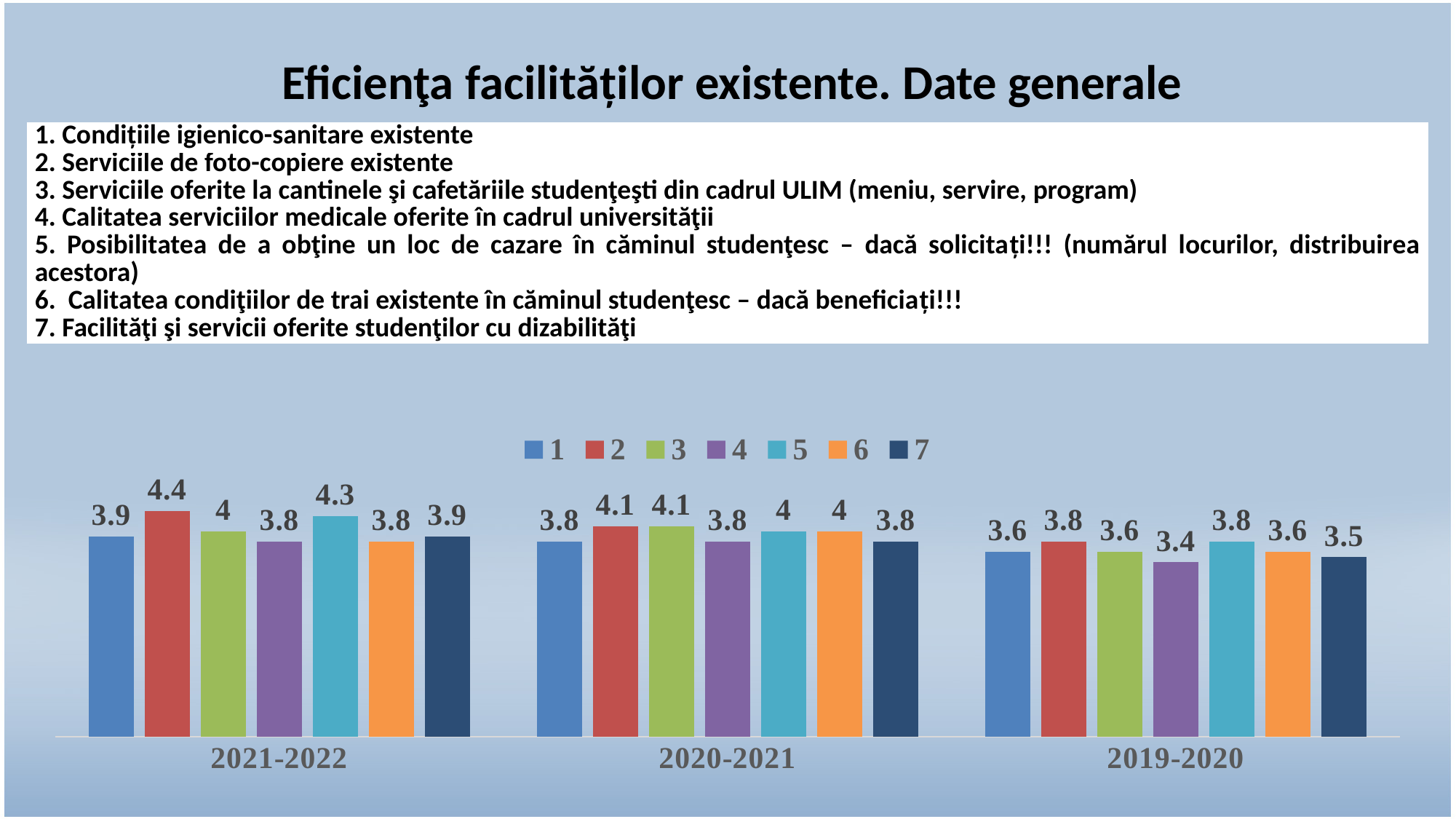
How many series does the legend list? 7 Which series has the lowest value in 2019-2020? 4 How many academic year categories are shown on the x axis? 3 What kind of chart is shown on the slide? bar chart What is the value for series 4 in 2019-2020? 3.4 What colour are the bars for series 6? orange What is the value for series 2 in 2021-2022? 4.4 What is the value for series 5 in 2020-2021? 4 Does the value for series 7 rise or fall from 2021-2022 to 2019-2020 along the x axis? fall Which is larger: the value for series 5 in 2021-2022 or the value for series 5 in 2020-2021? 2021-2022 What is the difference between the value for series 2 in 2021-2022 and its value in 2019-2020? 0.6 Which series has the highest value in 2021-2022? 2